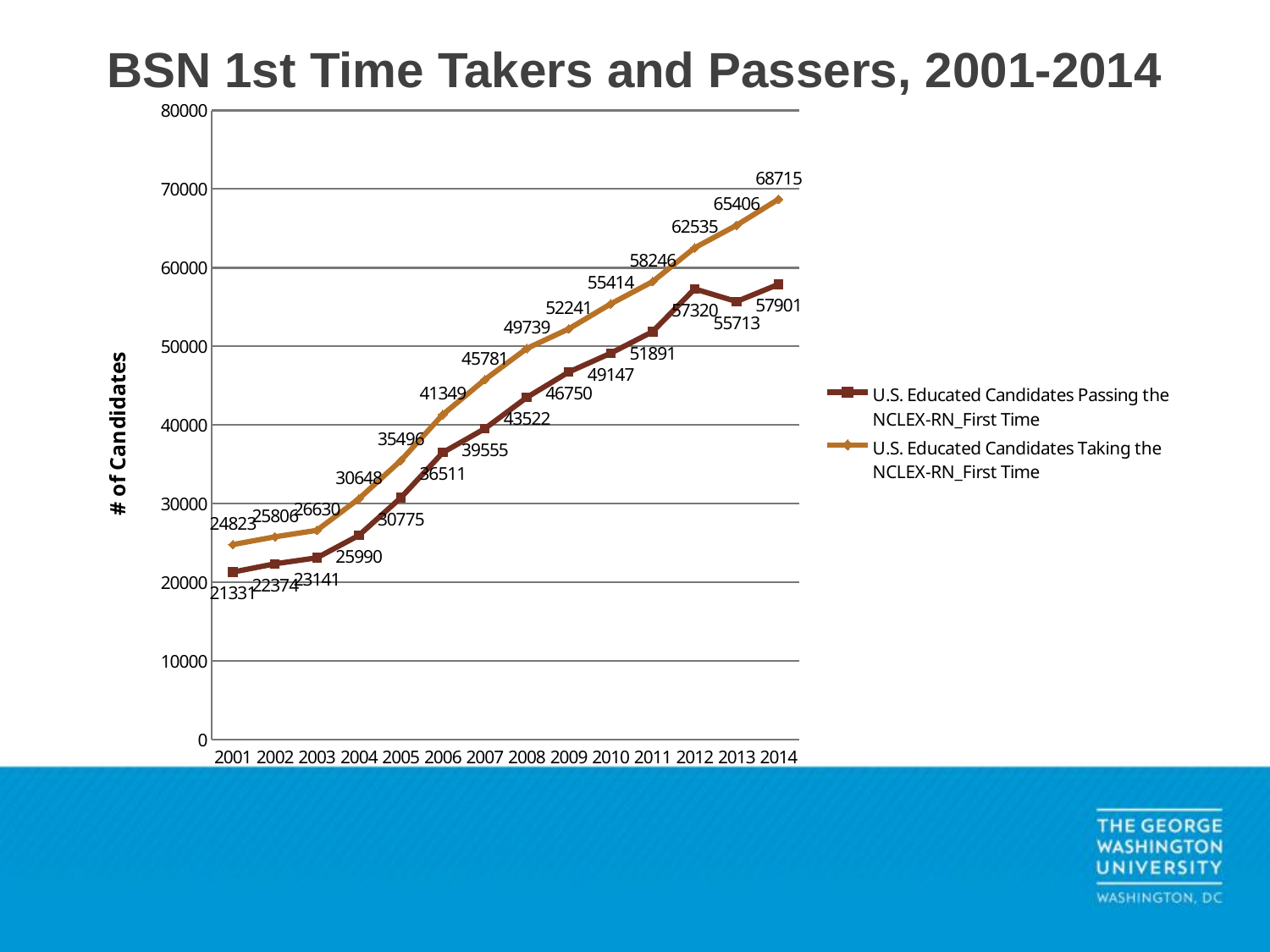
What type of chart is shown on the slide? Line chart What is the number of U.S. Educated Candidates Taking the NCLEX-RN for the first time in 2014? 68715 What is the number of U.S. Educated Candidates Passing the NCLEX-RN for the first time in 2001? 21331 How many years are plotted along the x axis? 14 What is the overall trend of the number of U.S. Educated Candidates Taking the NCLEX-RN for the first time from 2001 to 2014? Rising In which year is the number of U.S. Educated Candidates Taking the NCLEX-RN for the first time the highest? 2014 How many series does the legend list? 2 Which is larger: the number of candidates passing in 2012 or the number passing in 2013? 2012 What is the difference between the number of candidates taking and the number passing the NCLEX-RN for the first time in 2014? 10814 In which year is the number of U.S. Educated Candidates Passing the NCLEX-RN for the first time the lowest? 2001 What is the label of the y axis? # of Candidates What is the number of U.S. Educated Candidates Passing the NCLEX-RN for the first time in 2013? 55713